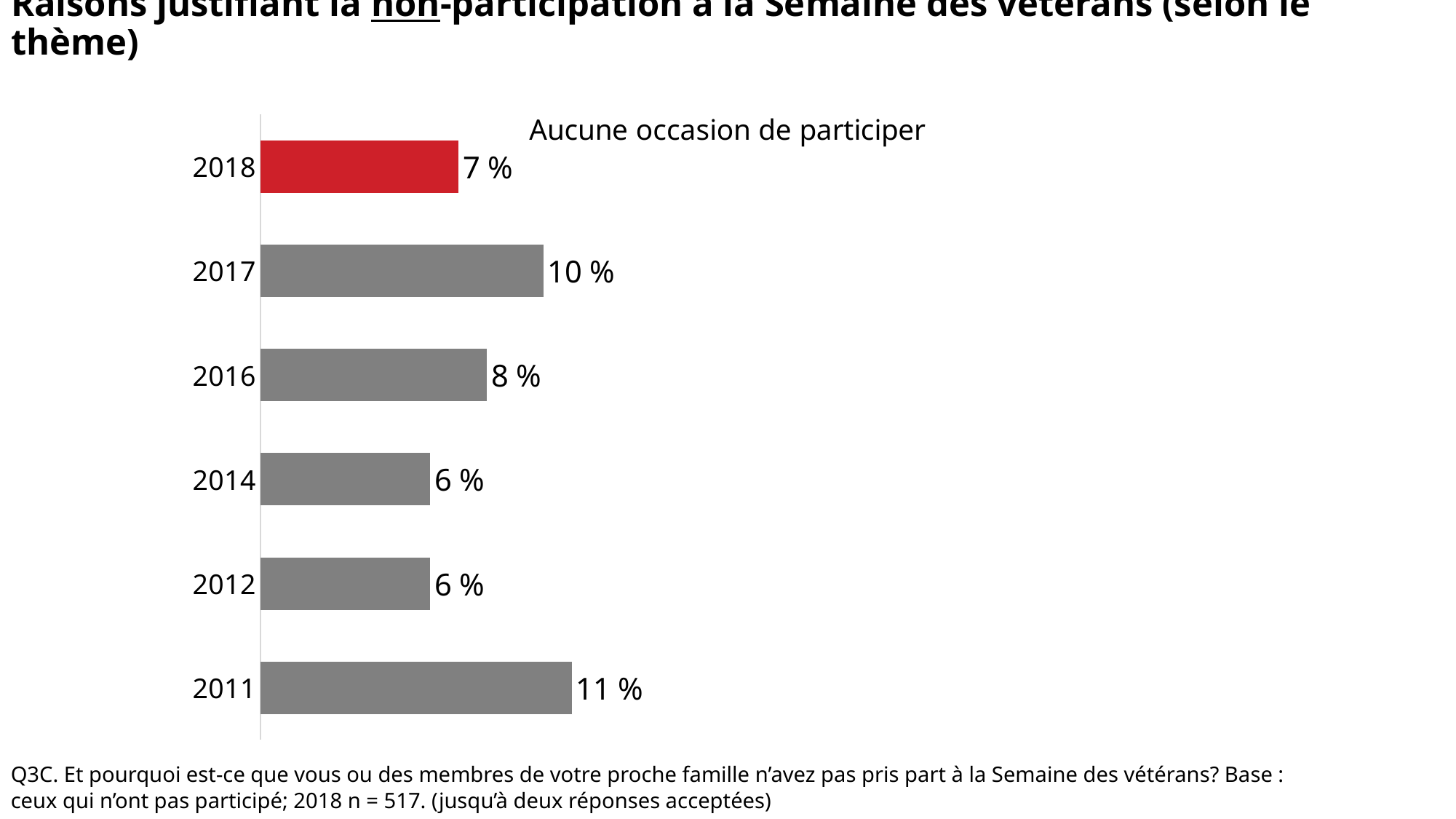
What is the difference between the values for 2011 and 2014? 5 % What is the value for 2016? 8 % What is the difference between the values for 2017 and 2018? 3 % Which year has the highest value? 2011 Which year's bar is coloured red? 2018 What kind of chart is shown on the slide? Bar chart What is the title of the chart? Aucune occasion de participer How many years are shown in the chart? 6 What is the value for 2017? 10 % What is the value for 2018 in the 'Aucune occasion de participer' chart? 7 % Which is larger, the value for 2016 or the value for 2018? 2016 What is the value for 2011? 11 %